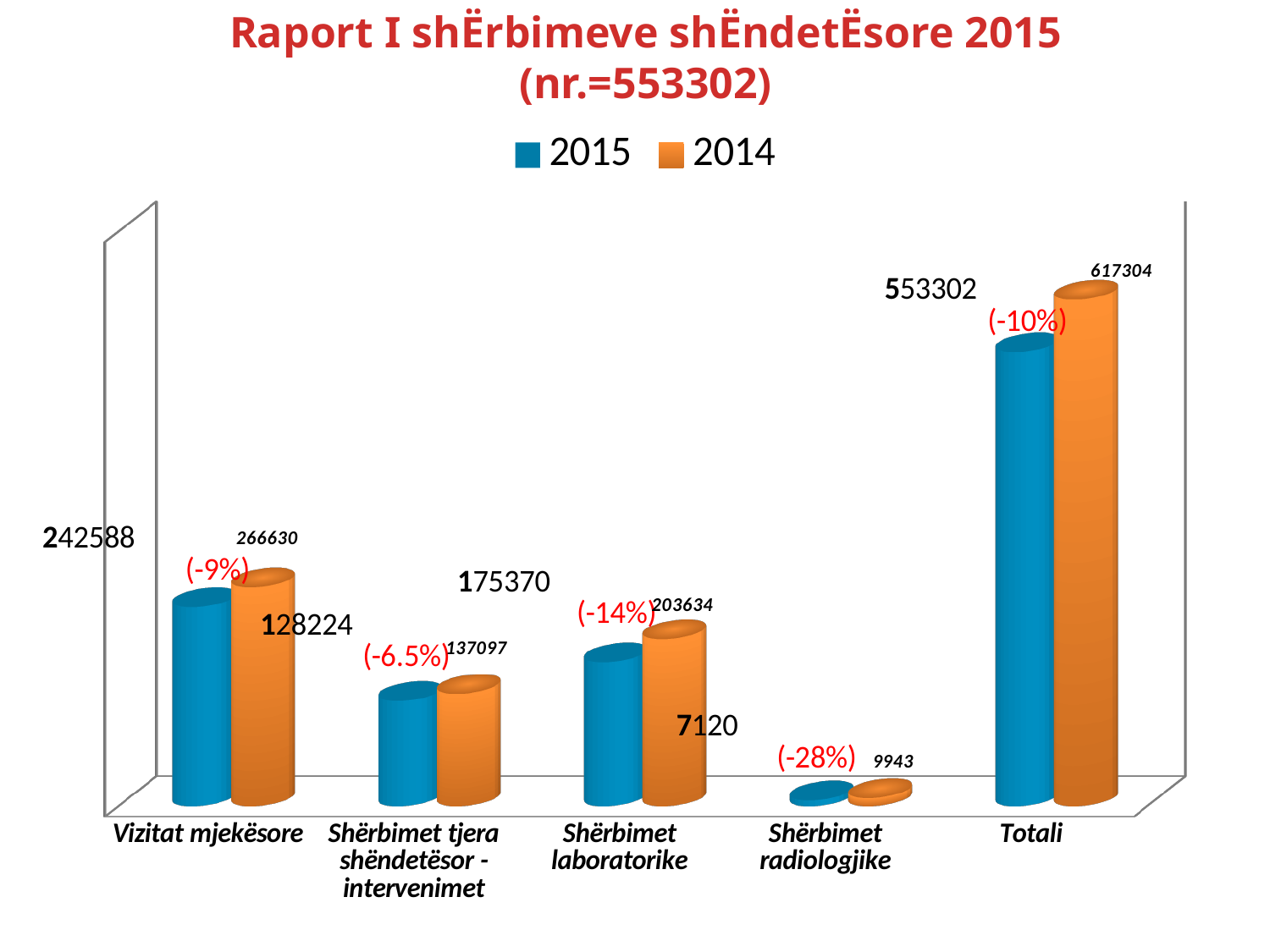
How many series does the legend list? 2 What is the difference between the 2014 and 2015 values for Shërbimet laboratorike? 28264 What percentage change is shown for Shërbimet tjera shëndetësor - intervenimet? (-6.5%) How many categories are shown on the x axis? 5 What is the 2015 value for Vizitat mjekësore? 242588 What is the 2014 value for Totali? 617304 Which is larger for Vizitat mjekësore, the 2015 value or the 2014 value? 2014 What is the 2014 value for Shërbimet laboratorike? 203634 What is the 2015 value for Shërbimet radiologjike? 7120 What is the difference between the 2014 and 2015 values for Totali? 64002 Excluding Totali, which category has the lowest 2015 value? Shërbimet radiologjike Excluding Totali, which category has the highest 2014 value? Vizitat mjekësore